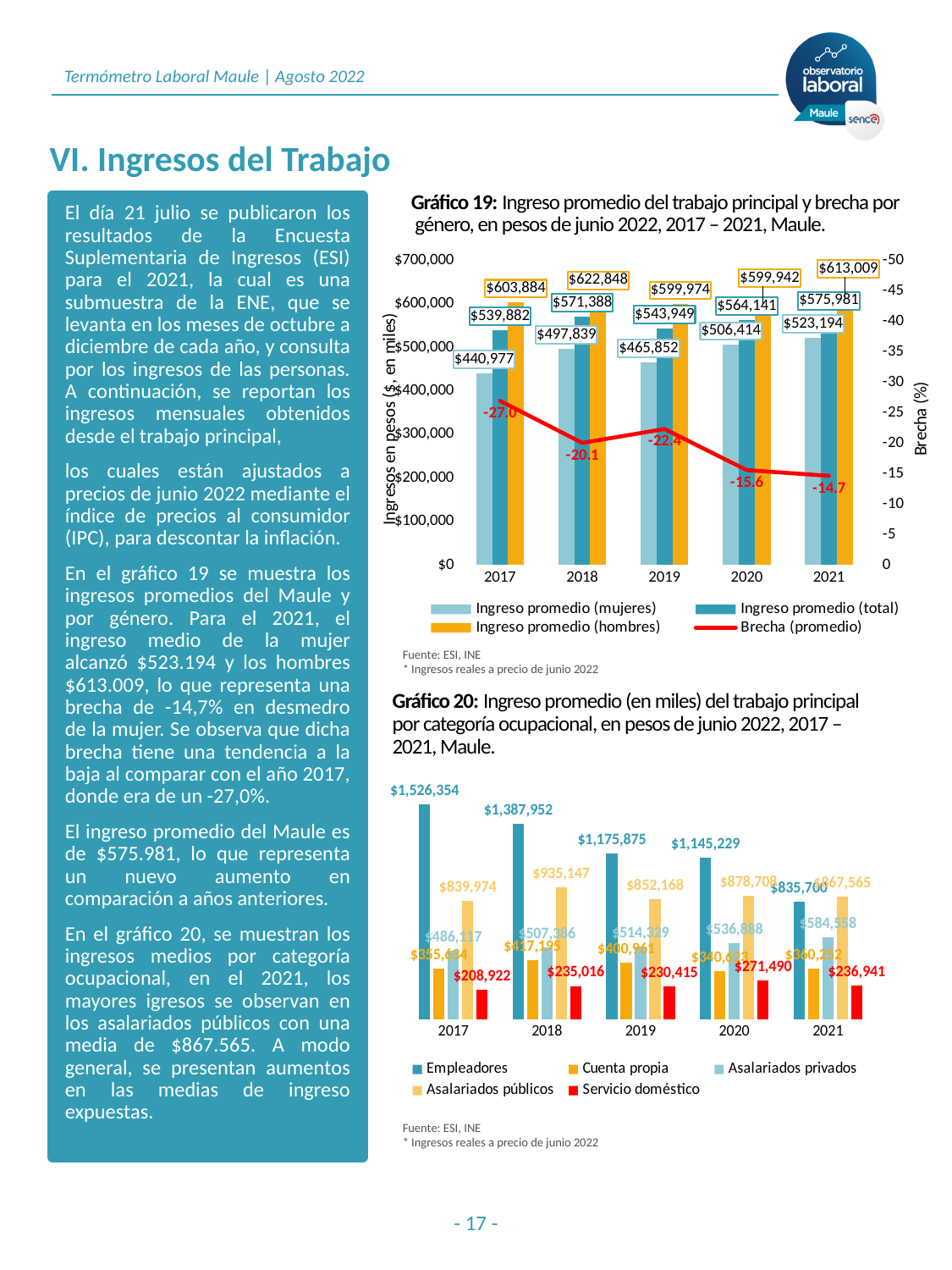
In Gráfico 19, what was the average income for women (Ingreso promedio mujeres) in 2021? $523,194 In Gráfico 20, how many occupational categories does the legend list? 5 In Gráfico 20, which occupational category had the highest average income in 2021? Asalariados públicos In Gráfico 19, what was the gender gap (Brecha promedio) in 2017? -27.0 In Gráfico 19, what is the difference between men's and women's average income in 2021? $89,815 In Gráfico 19, which year had the highest total average income (Ingreso promedio total)? 2021 In Gráfico 20, what was the average income of Empleadores in 2017? $1,526,354 In Gráfico 19, does the gender gap (Brecha promedio) generally rise or fall in magnitude from 2017 to 2021? fall In Gráfico 20, what was the average income of Servicio doméstico in 2020? $271,490 In Gráfico 19, what was the average income for men (Ingreso promedio hombres) in 2018? $622,848 In Gráfico 19, which year had the lowest average income for women? 2017 In Gráfico 19, how many series does the legend list? 4